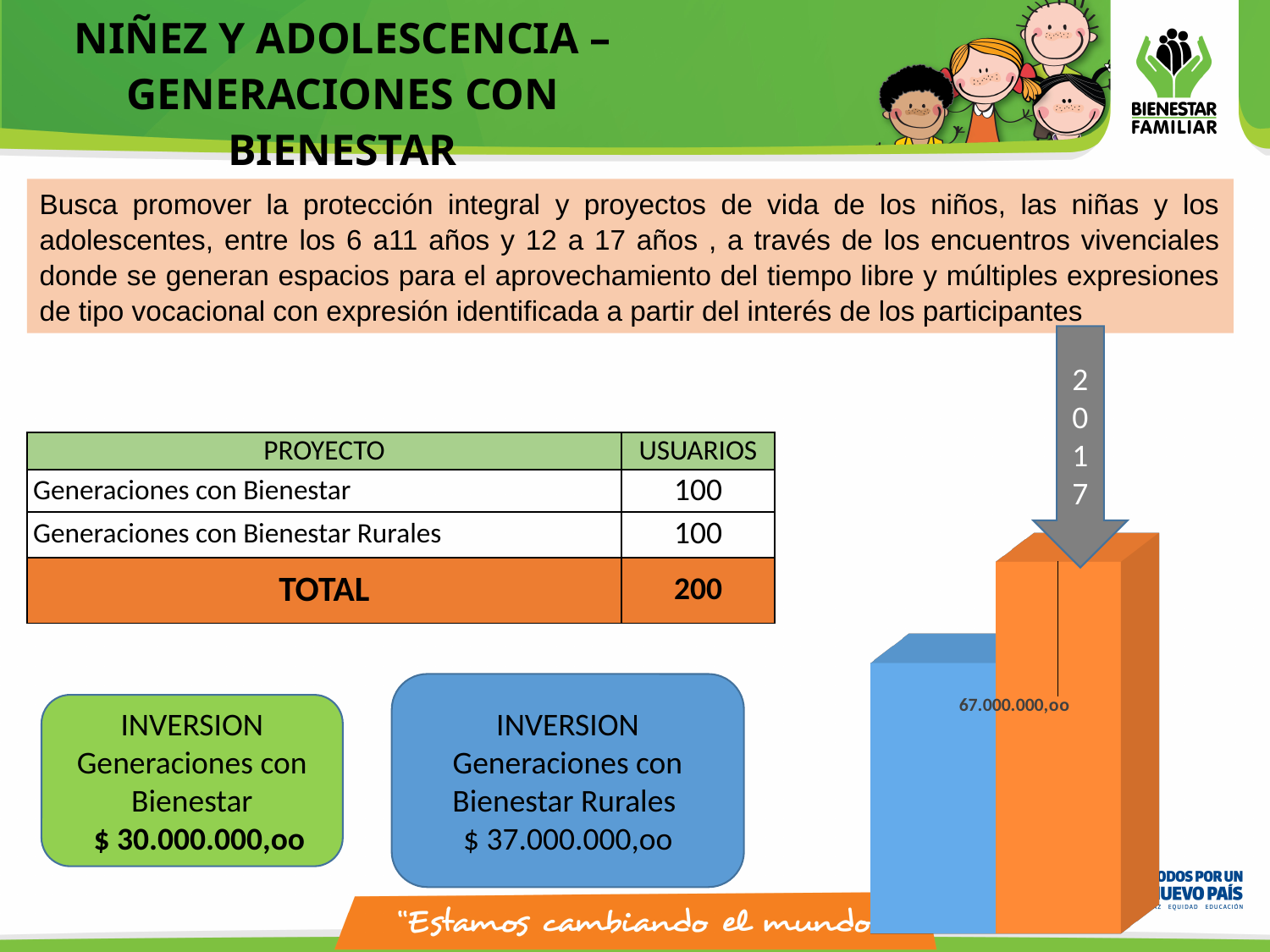
How many bars does the chart on the right side of the slide have? 2 What year is shown in the arrow above the chart? 2017 What two colours are the bars in the chart? blue and orange Which bar in the chart is the shortest, the blue one or the orange one? the blue one What kind of chart is shown on the right side of the slide? bar chart Is the orange bar taller or shorter than the blue bar in the chart? taller Which bar in the chart is the tallest, the blue one or the orange one? the orange one What value is printed on the orange bar of the chart? 67.000.000,oo